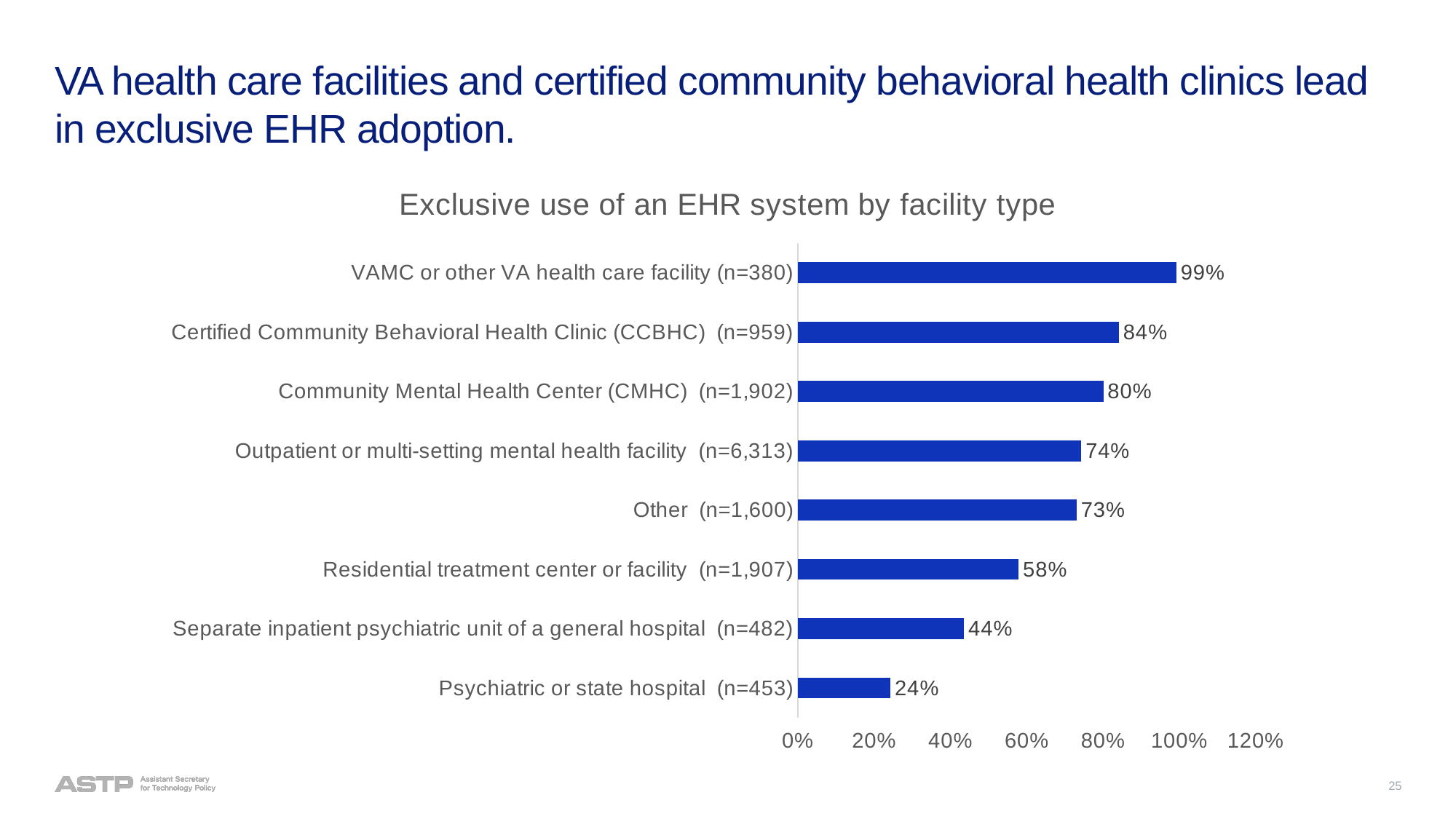
Which facility type has the lowest exclusive EHR use? Psychiatric or state hospital What is the difference between the values for Certified Community Behavioral Health Clinic (CCBHC) and Community Mental Health Center (CMHC)? 4% How many facility types are shown in the chart? 8 What is the value for Residential treatment center or facility? 58% What is the title of the chart? Exclusive use of an EHR system by facility type What is the value for VAMC or other VA health care facility? 99% What is the difference between the values for Separate inpatient psychiatric unit of a general hospital and Psychiatric or state hospital? 20% Which is larger, the value for Outpatient or multi-setting mental health facility or the value for Residential treatment center or facility? Outpatient or multi-setting mental health facility Which facility type has the highest exclusive EHR use? VAMC or other VA health care facility What is the value for Psychiatric or state hospital? 24% What kind of chart is shown on the slide? Bar chart Is the value for Separate inpatient psychiatric unit of a general hospital greater or less than 60%? less